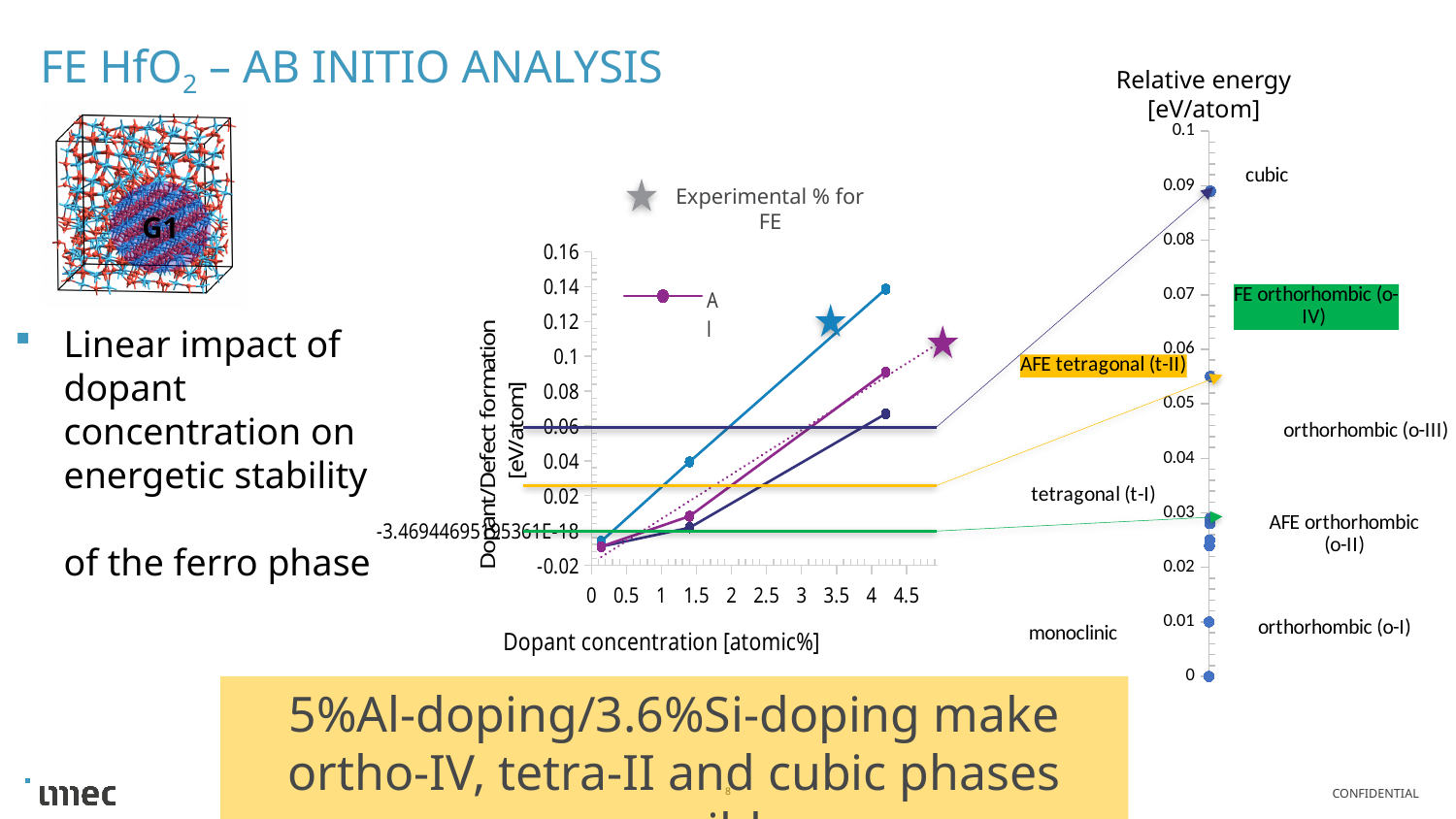
Do the plotted lines rise or fall as dopant concentration increases? rise What series name does the legend of the line chart show next to the purple marker? Al On the Relative energy axis, is the relative energy of the AFE tetragonal (t-II) phase greater or less than 0.04? greater Is the value of the light blue line at its highest dopant concentration greater or less than 0.12? greater What is the x-axis title of the line chart? Dopant concentration [atomic%] On the Relative energy axis, which phase has the highest relative energy? cubic On the Relative energy axis, which phase has the lowest relative energy? monoclinic Is the value of the dark blue line at its highest dopant concentration greater or less than 0.08? less What kind of chart is the plot of Dopant/Defect formation versus Dopant concentration? line chart At the highest dopant concentration, which line reaches a higher value, the light blue line or the dark blue line? light blue line